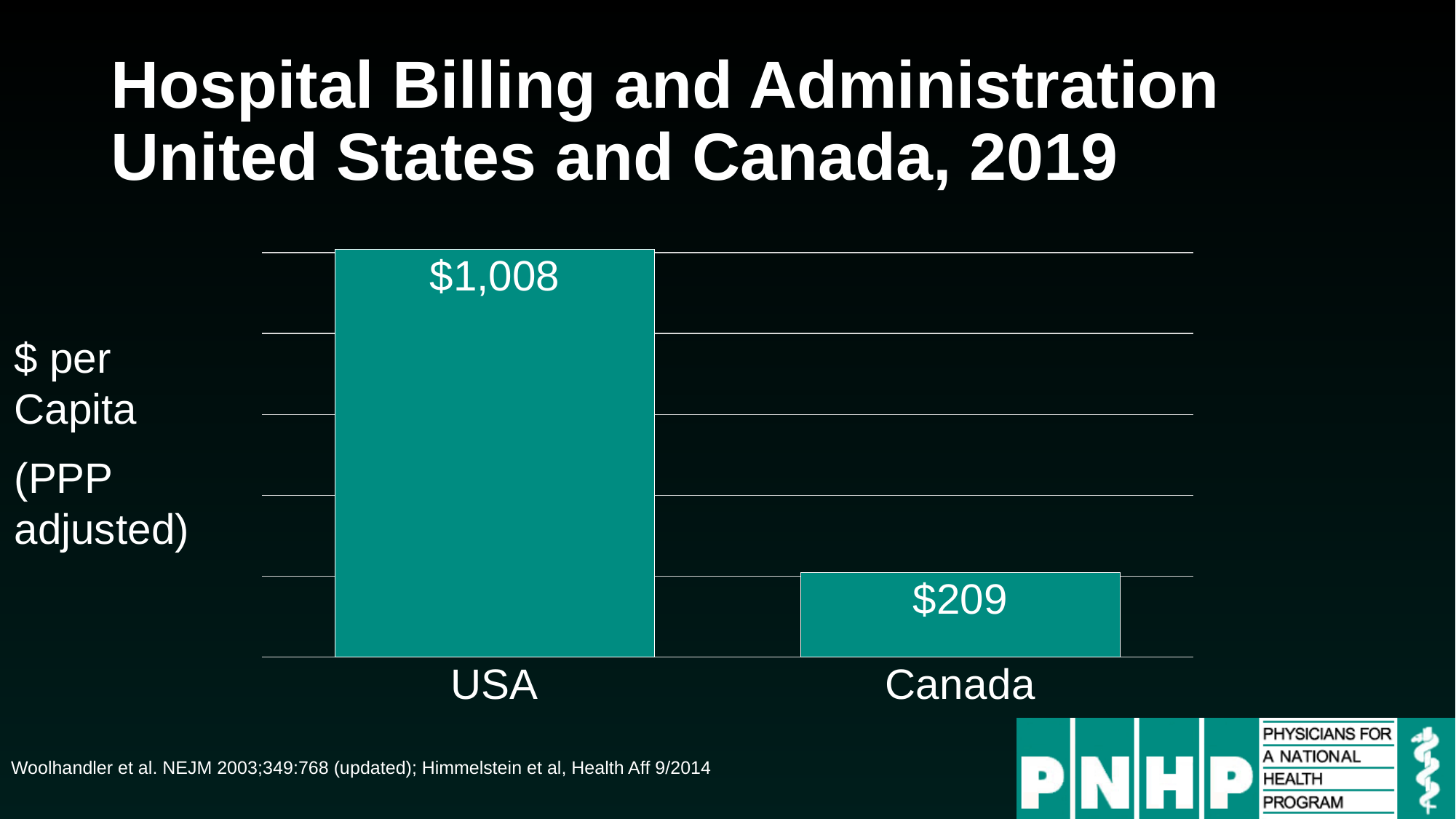
Which is larger, the value for USA or the value for Canada? USA What is the value for Canada? $209 What kind of chart is shown on the slide? Bar chart What is the value for USA? $1,008 What unit is shown on the vertical axis label? $ per Capita (PPP adjusted) What is the title of the slide? Hospital Billing and Administration United States and Canada, 2019 What is the difference between the values for USA and Canada? $799 How many categories are shown in the chart? 2 Which category has the highest value? USA Which category has the lowest value? Canada